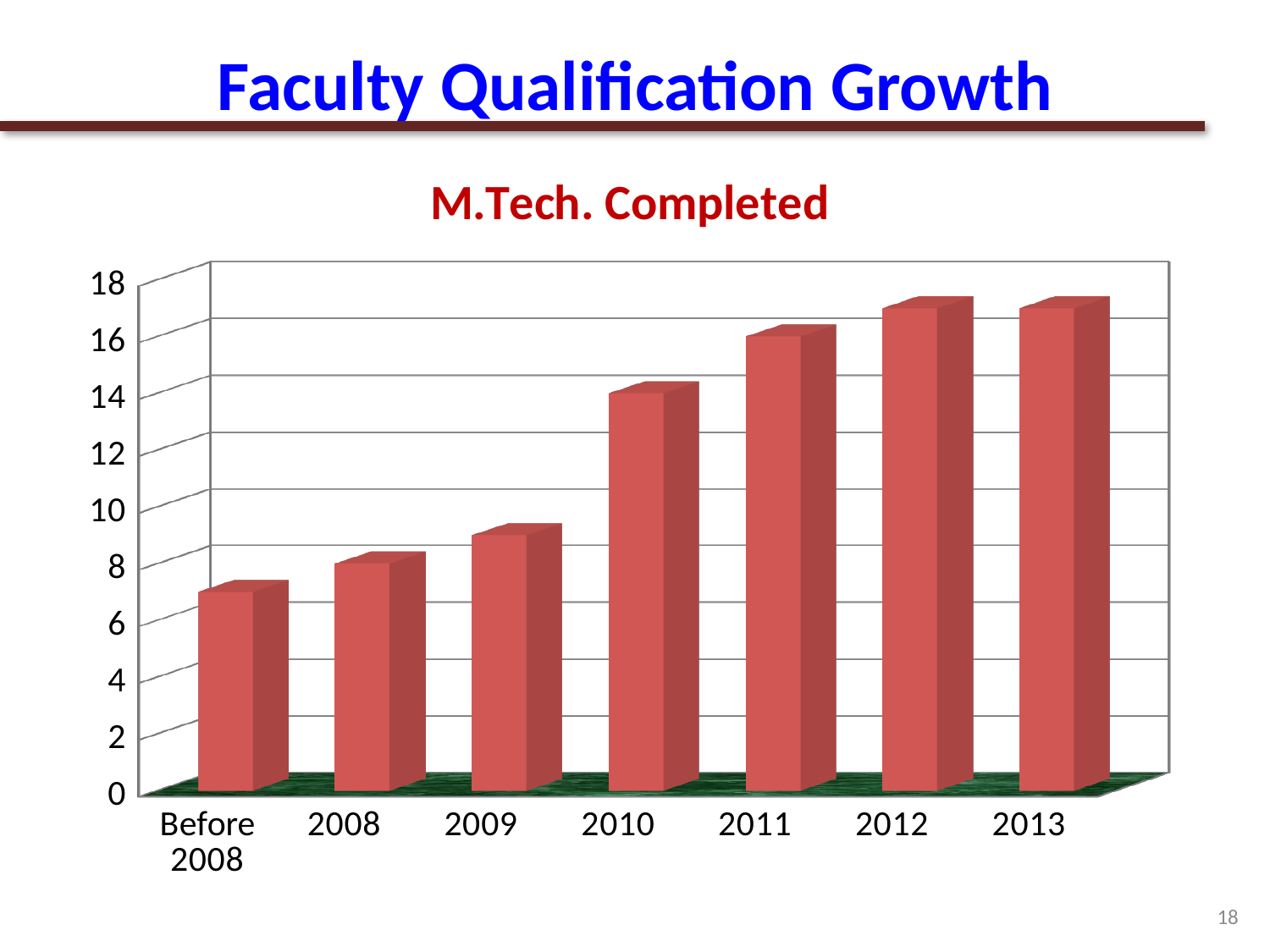
Is the value for 2012 greater or less than 16? greater Which category has the lowest value in the chart? Before 2008 Is the value for 2013 greater or less than 18? less Do the values generally rise or fall from Before 2008 to 2013? rise Which is larger, the value for 2011 or the value for 2008? 2011 Is the value for Before 2008 greater or less than 6? greater What type of chart is shown on the slide? bar chart What is the title of the chart? M.Tech. Completed Which is larger, the value for 2009 or the value for 2010? 2010 How many categories are shown on the x axis of the chart? 7 What colour are the bars in the chart? red